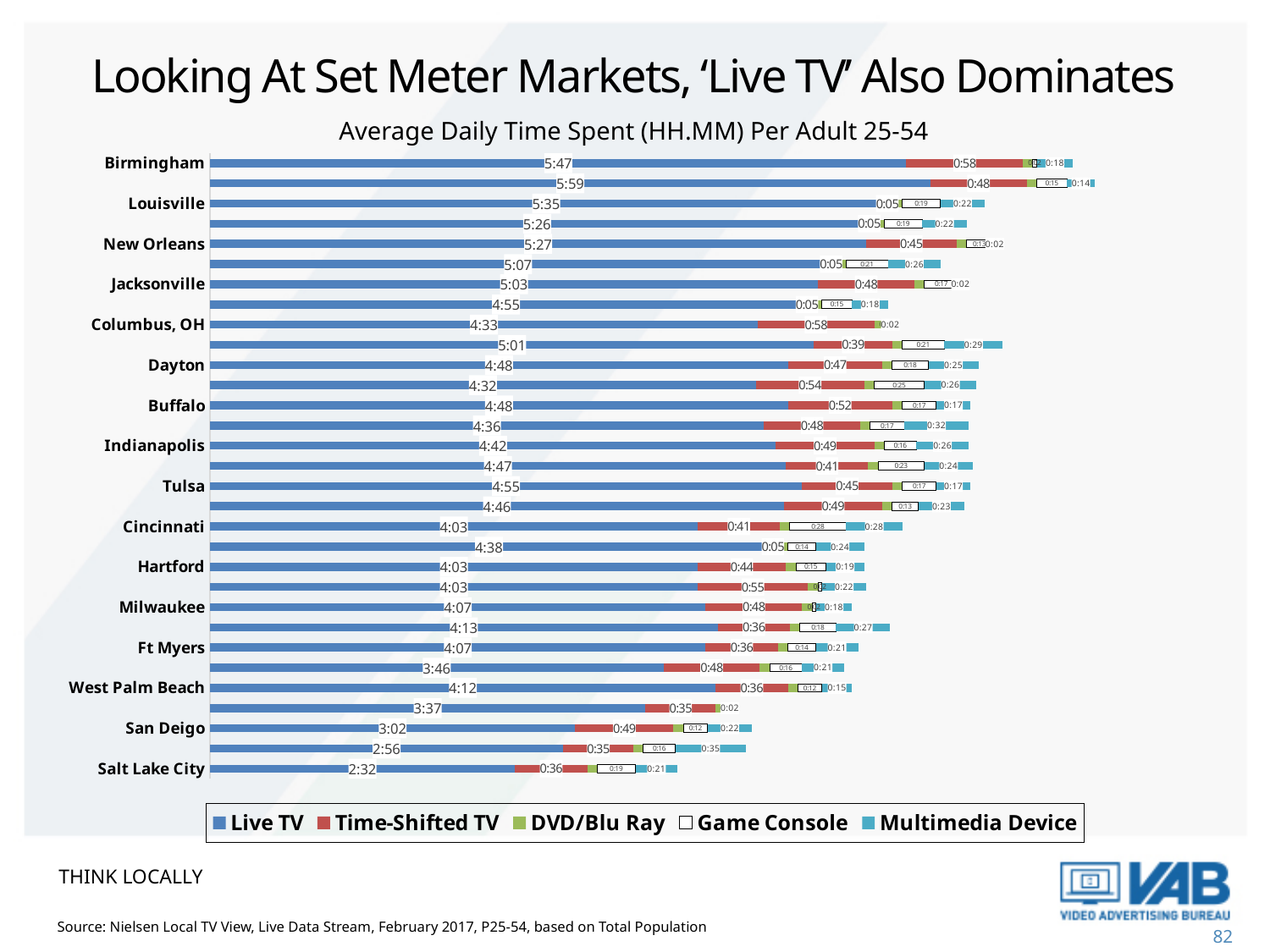
What is the Live TV value for Salt Lake City? 2:32 What is the difference between the Live TV values for Birmingham and Salt Lake City? 3:15 What is the subtitle of the chart? Average Daily Time Spent (HH.MM) Per Adult 25-54 Do the Live TV values generally rise or fall going from the top market to the bottom market? Fall What is the Live TV value for Birmingham? 5:47 Which labeled market has the lowest Live TV value? Salt Lake City What is the Time-Shifted TV value for Louisville? 0:05 What type of chart is shown on the slide? Stacked horizontal bar chart Which has a larger Live TV value, Tulsa or Dayton? Tulsa What is the Live TV value for Tulsa? 4:55 What is the Time-Shifted TV value for New Orleans? 0:45 How many series does the legend list? 5